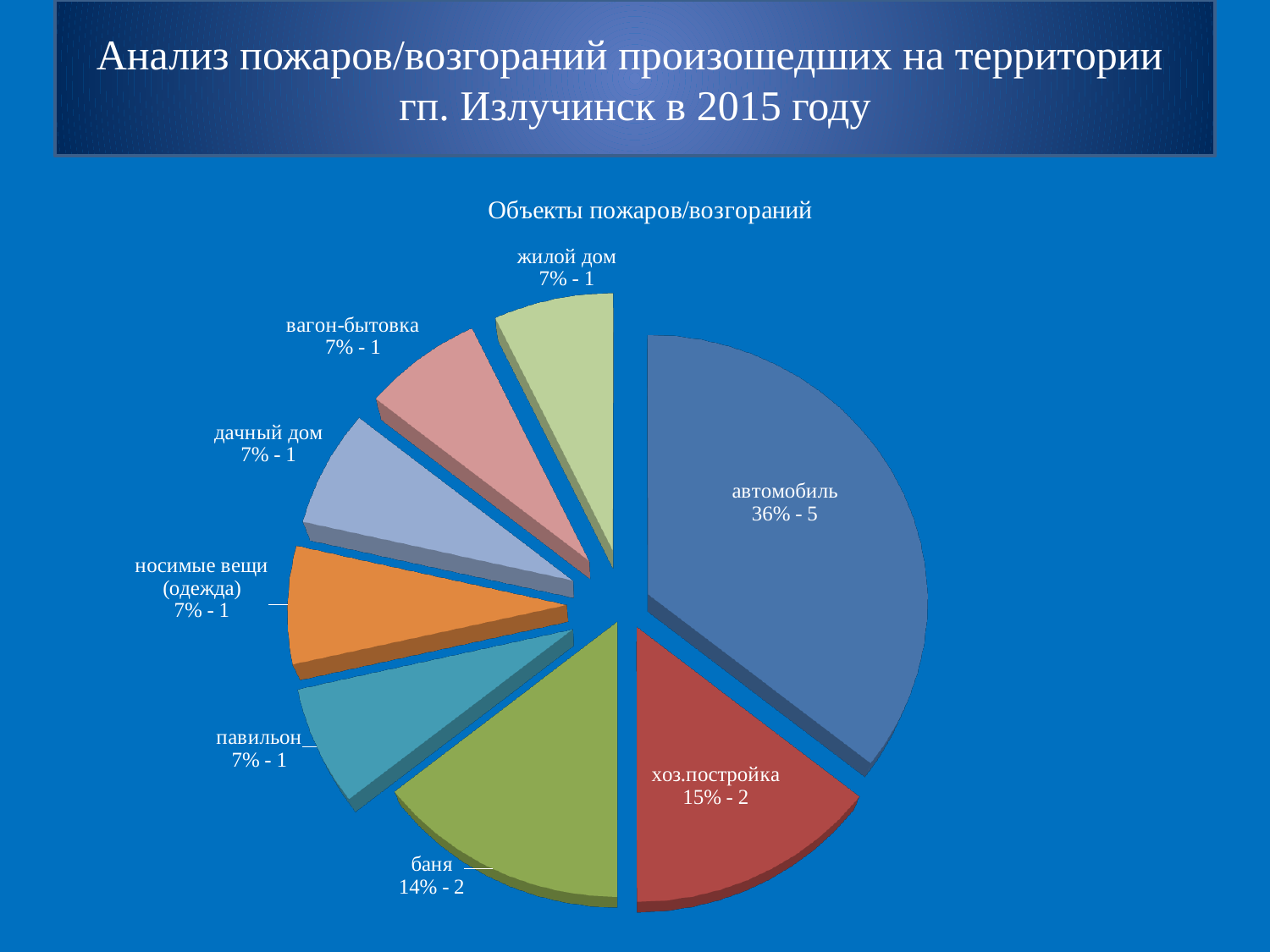
What share of the pie does автомобиль account for? 36% How many categories (slices) does the pie chart have? 8 Which is larger, the share for хоз.постройка or the share for баня? хоз.постройка What is the title of the chart? Объекты пожаров/возгораний What percentage is shown for носимые вещи (одежда)? 7% What is the difference in percentage points between автомобиль and хоз.постройка? 21 How many fires in total are represented by the автомобиль and баня slices combined? 7 How many fires are recorded for хоз.постройка? 2 What percentage is shown for баня? 14% How many fires are recorded for жилой дом? 1 Which category has the largest share of the pie? автомобиль What kind of chart is shown on the slide? pie chart